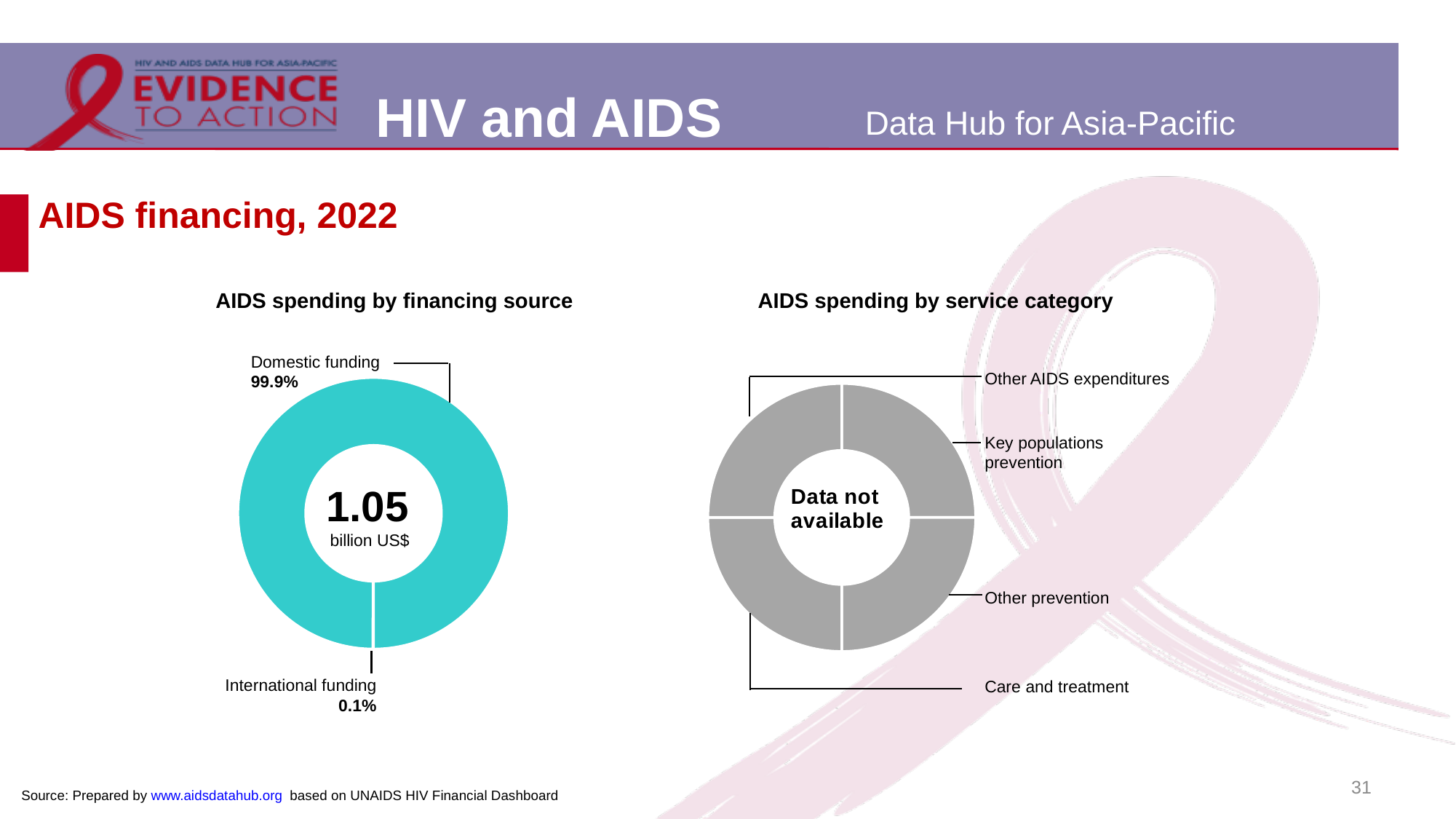
In the 'AIDS spending by financing source' chart, which financing source has the smallest share? International funding In the 'AIDS spending by financing source' chart, what total amount is shown in the centre of the donut? 1.05 billion US$ What year does the slide title say the AIDS financing data refers to? 2022 How many financing sources are shown in the 'AIDS spending by financing source' chart? 2 In the 'AIDS spending by financing source' chart, what share of AIDS spending comes from international funding? 0.1% What type of chart is the 'AIDS spending by financing source' chart? Donut chart In the 'AIDS spending by financing source' chart, what share of AIDS spending comes from domestic funding? 99.9% In the 'AIDS spending by financing source' chart, what is the difference in percentage points between domestic funding and international funding? 99.8 percentage points What text appears in the centre of the 'AIDS spending by service category' chart? Data not available In the 'AIDS spending by financing source' chart, which is larger: domestic funding or international funding? Domestic funding How many service categories are labelled in the 'AIDS spending by service category' chart? 4 In the 'AIDS spending by financing source' chart, which financing source has the largest share? Domestic funding